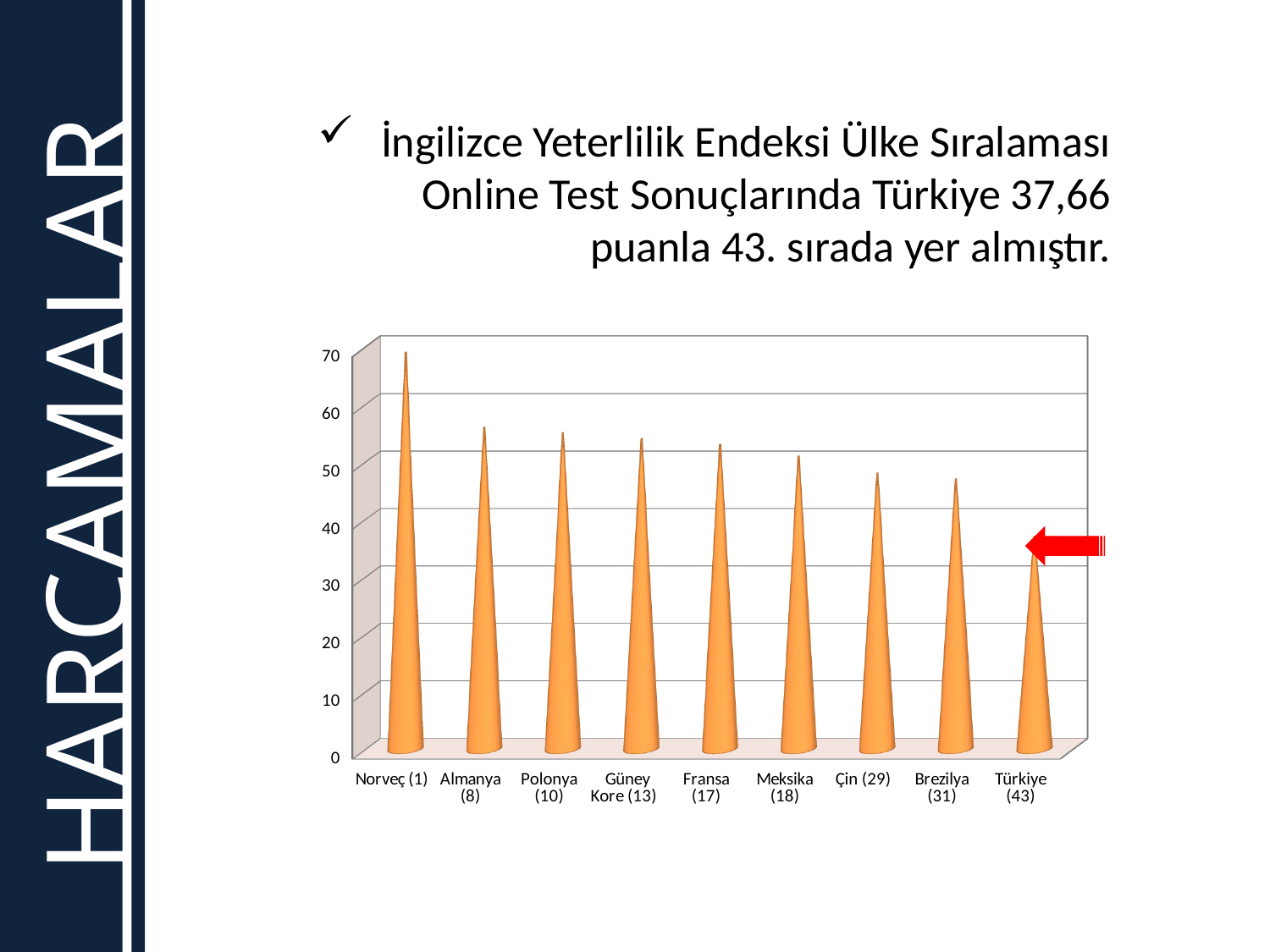
Which has a larger value, Almanya (8) or Brezilya (31)? Almanya (8) Which country has the lowest value in the chart? Türkiye (43) Is the value for Norveç (1) greater or less than 60? greater Which country has the highest value in the chart? Norveç (1) What kind of chart is shown on the slide? bar chart Is the value for Almanya (8) greater or less than 50? greater Is the value for Brezilya (31) greater or less than 50? less Do the values rise or fall moving from left to right along the x axis? fall According to the slide text, what score does Türkiye have in the English proficiency index? 37,66 Which country's bar does the red arrow on the chart point to? Türkiye (43) How many countries are shown on the x axis of the chart? 9